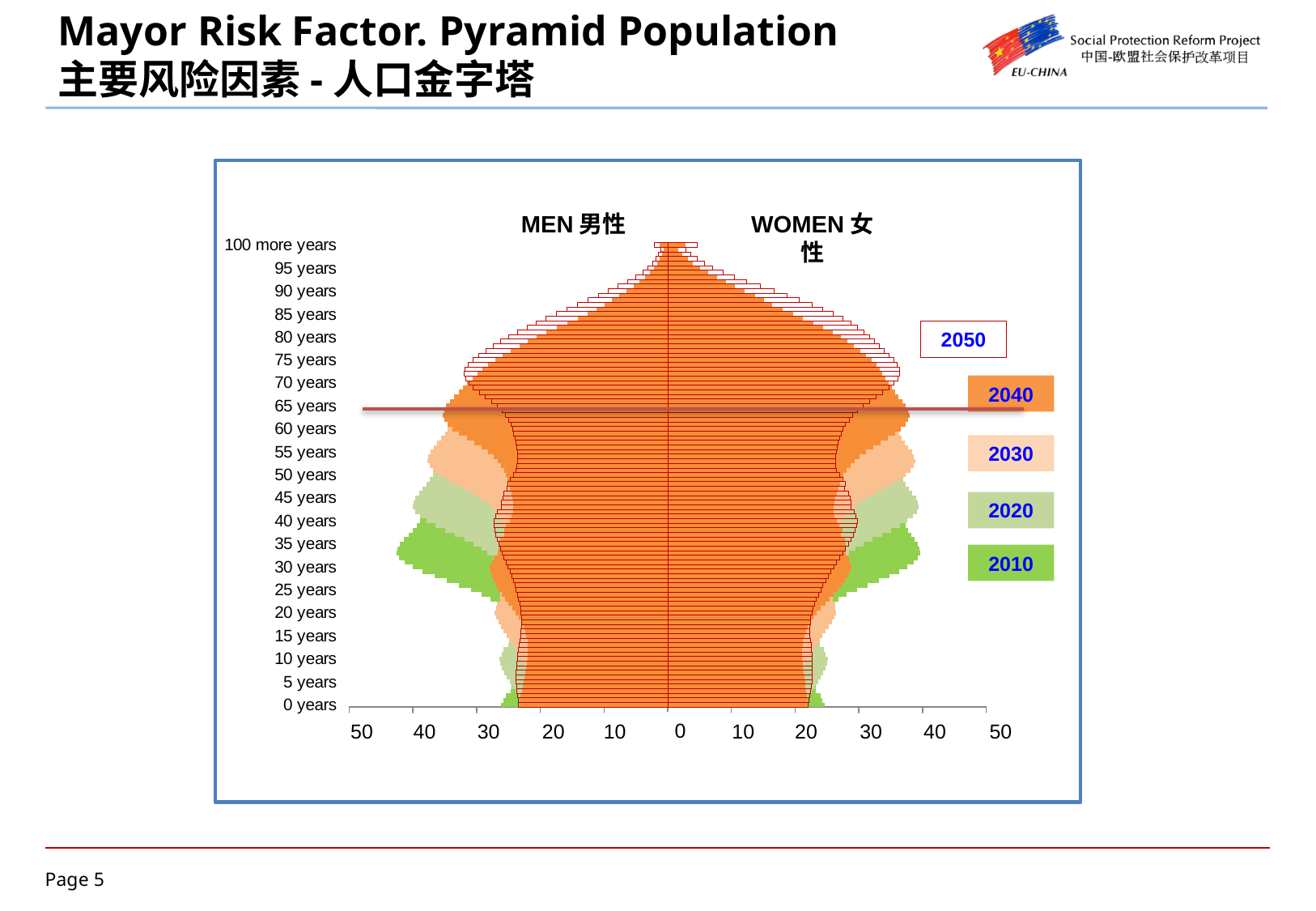
Is the 2010 value for men aged 35 years greater or less than 40? greater Which side of the pyramid shows men? Left Which age group does the horizontal red line across the pyramid mark? 65 years Which years are listed in the legend? 2050, 2040, 2030, 2020, 2010 What kind of chart is shown on the slide? Bar chart (population pyramid) How many years (series) does the legend list? 5 Is the 2010 value for men aged 0 years greater or less than 30? less What is the highest value shown on the horizontal axis? 50 Is the 2010 value for women aged 35 years greater or less than 30? greater How many age groups are listed on the vertical axis? 21